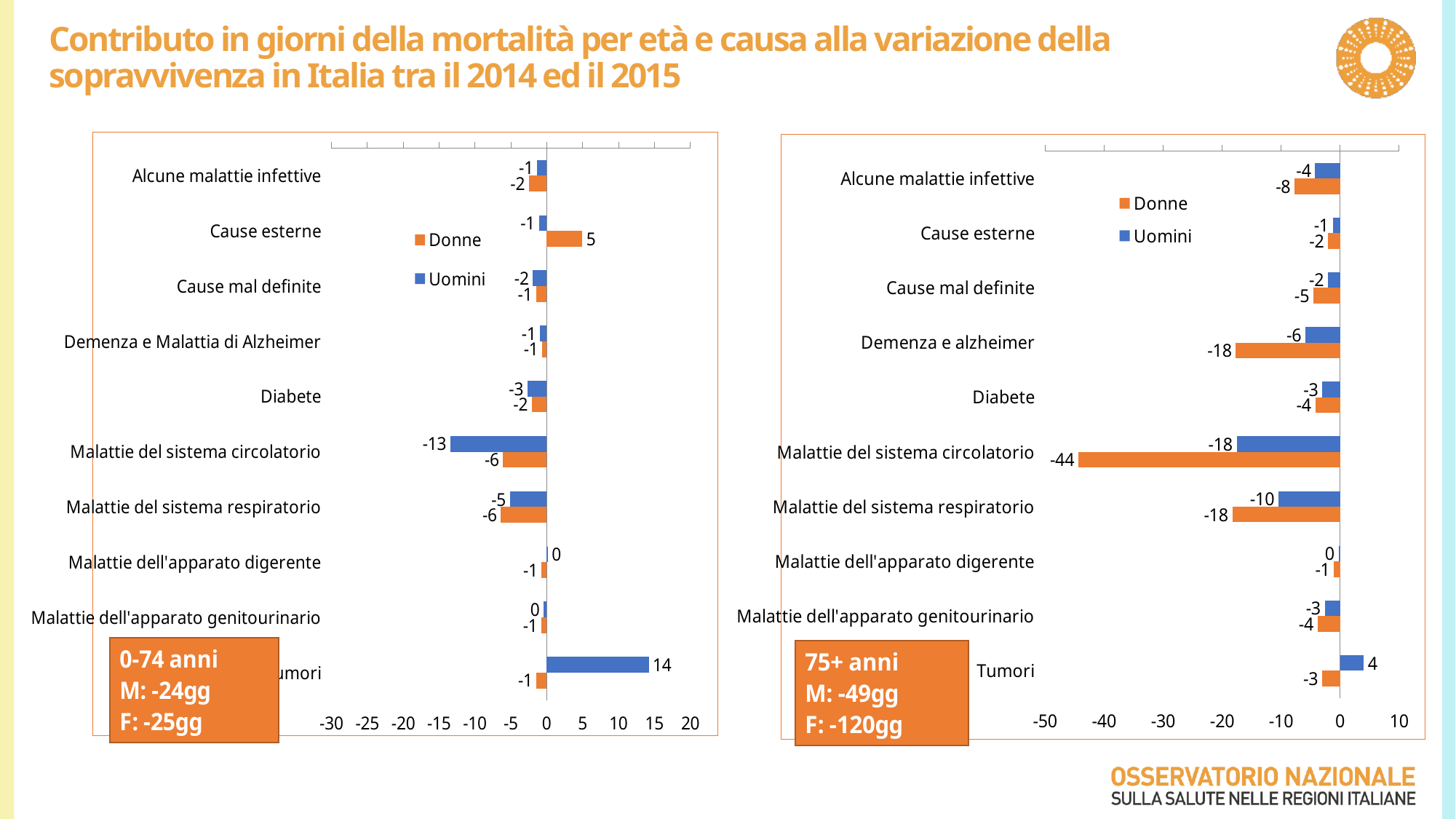
In the right chart (75+ anni), which category has the lowest value for Donne? Malattie del sistema circolatorio In the left chart (0-74 anni), which category has the highest value for Uomini? Tumori In the left chart (0-74 anni), which is larger for Malattie del sistema circolatorio, the Donne value or the Uomini value? Donne In the left chart (0-74 anni), which colour represents the Donne series? Orange How many categories are shown in the right chart (75+ anni)? 10 What type of chart is the right chart (75+ anni)? Bar chart In the right chart (75+ anni), what is the difference between the Donne and Uomini values for Malattie del sistema respiratorio? 8 In the left chart (0-74 anni), what is the value for Donne for Cause esterne? 5 In the right chart (75+ anni), what is the value for Donne for Malattie del sistema circolatorio? -44 In the right chart (75+ anni), what is the value for Uomini for Tumori? 4 In the left chart (0-74 anni), what is the value for Uomini for Malattie del sistema circolatorio? -13 How many series does the legend of the left chart (0-74 anni) list? 2